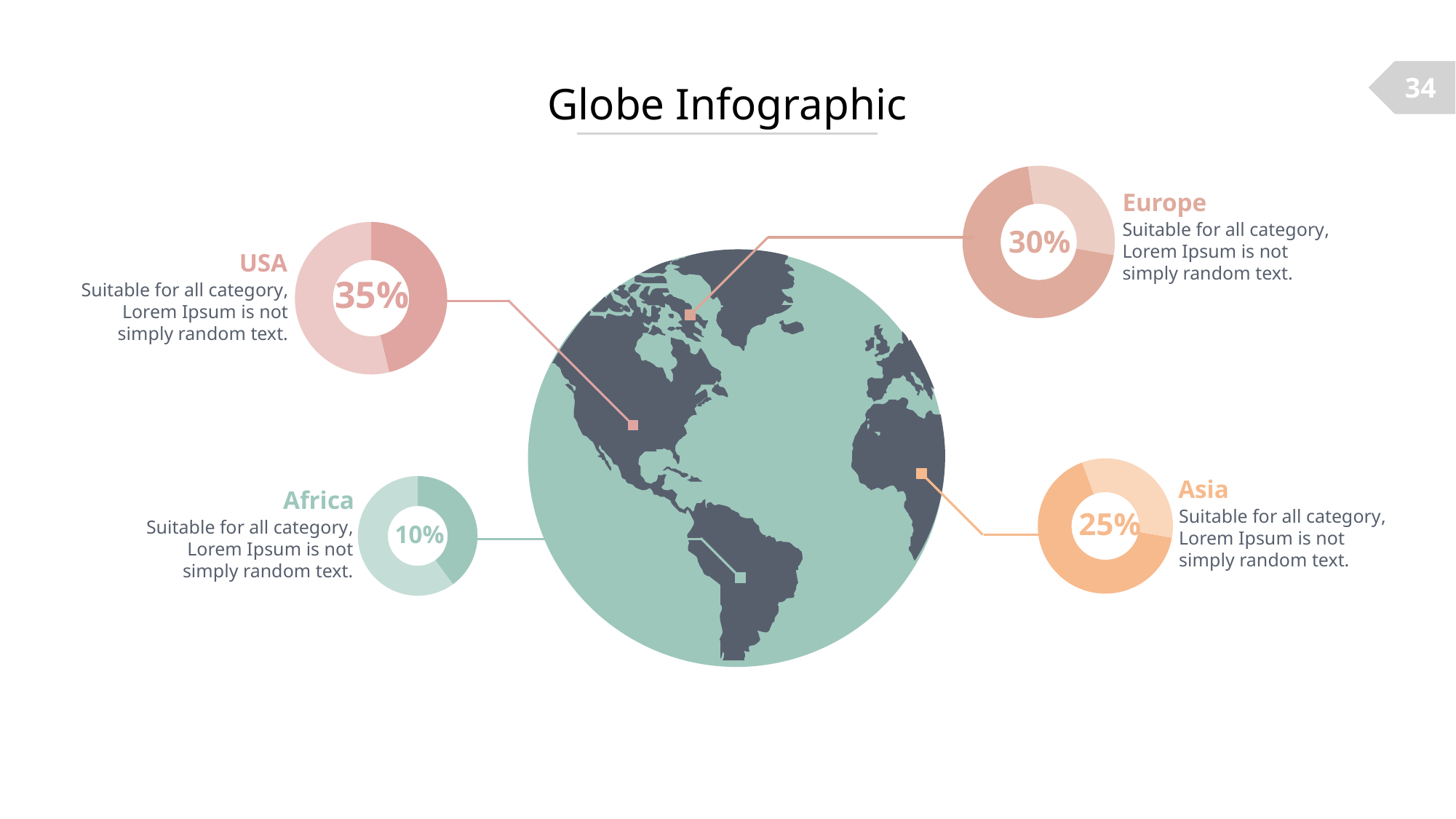
What kind of chart is used to show each region's percentage? Donut chart Which is larger, the Europe percentage or the Asia percentage? Europe Which region's donut chart shows the highest percentage? USA What is the difference between the USA percentage and the Africa percentage? 25% What percentage is shown in the USA donut chart? 35% How many donut charts are shown on the slide? 4 What is the title of the slide? Globe Infographic What is the difference between the Europe percentage and the Asia percentage? 5% What percentage is shown in the Asia donut chart? 25% Which region's donut chart shows the lowest percentage? Africa What percentage is shown in the Africa donut chart? 10% What percentage is shown in the Europe donut chart? 30%